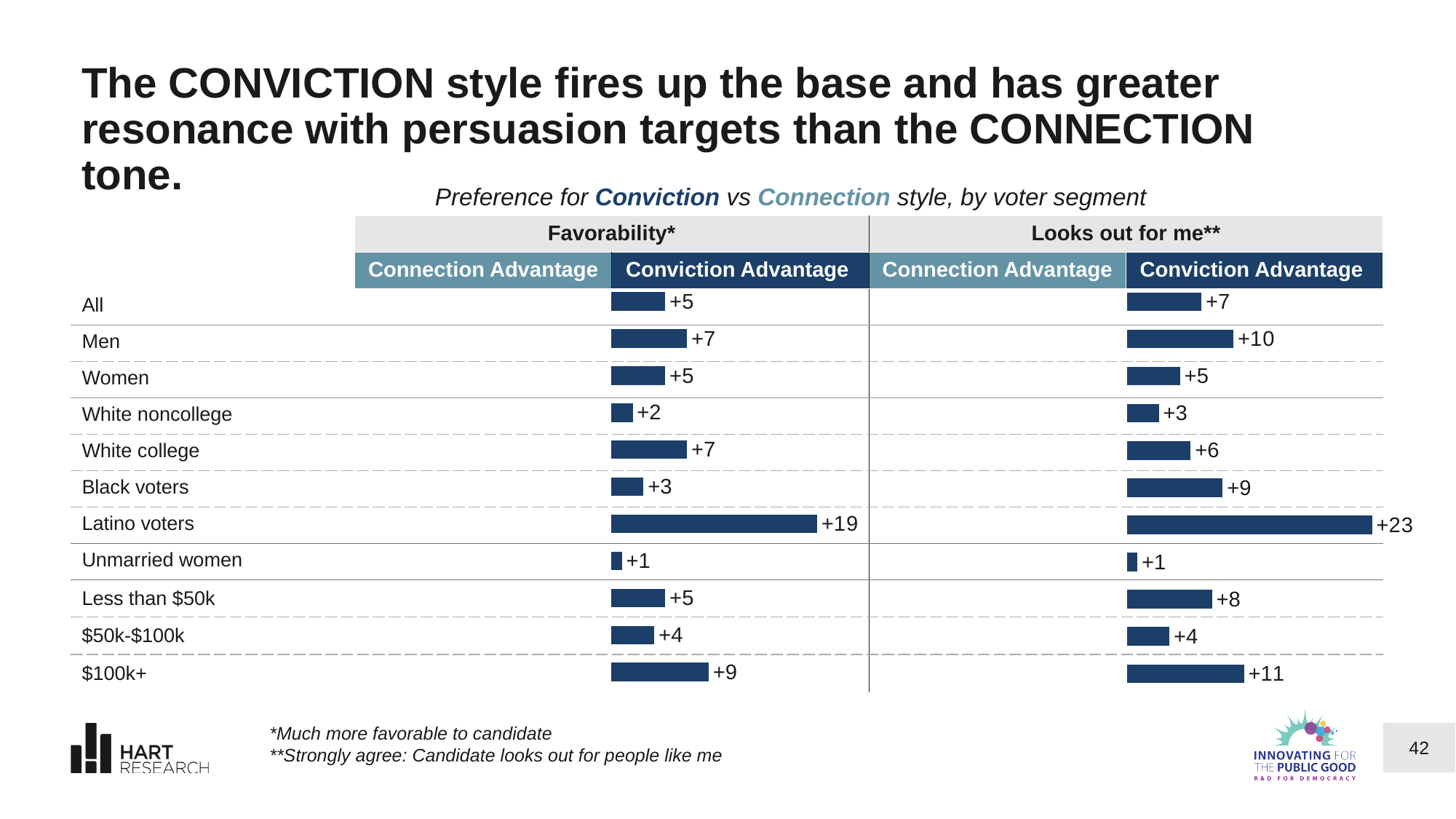
How many voter segments are shown in the Favorability chart? 11 In the Looks out for me chart, what is the Conviction advantage for Men? +10 In the Looks out for me chart, which voter segment has the smallest Conviction advantage? Unmarried women What type of chart is used to show the Conviction advantage values? Bar chart Which chart shows a larger value for Less than $50k, Favorability or Looks out for me? Looks out for me In the Looks out for me chart, what is the difference between the values for Latino voters and $100k+? 12 In the Favorability chart, what is the difference between the values for $100k+ and $50k-$100k? 5 In the Favorability chart, what is the Conviction advantage for Latino voters? +19 In the Looks out for me chart, what is the value for Black voters? +9 In the Favorability chart, do any voter segments show a Connection advantage? No In the Favorability chart, which voter segment has the largest Conviction advantage? Latino voters In the Favorability chart, which is larger: the value for Men or the value for Black voters? Men